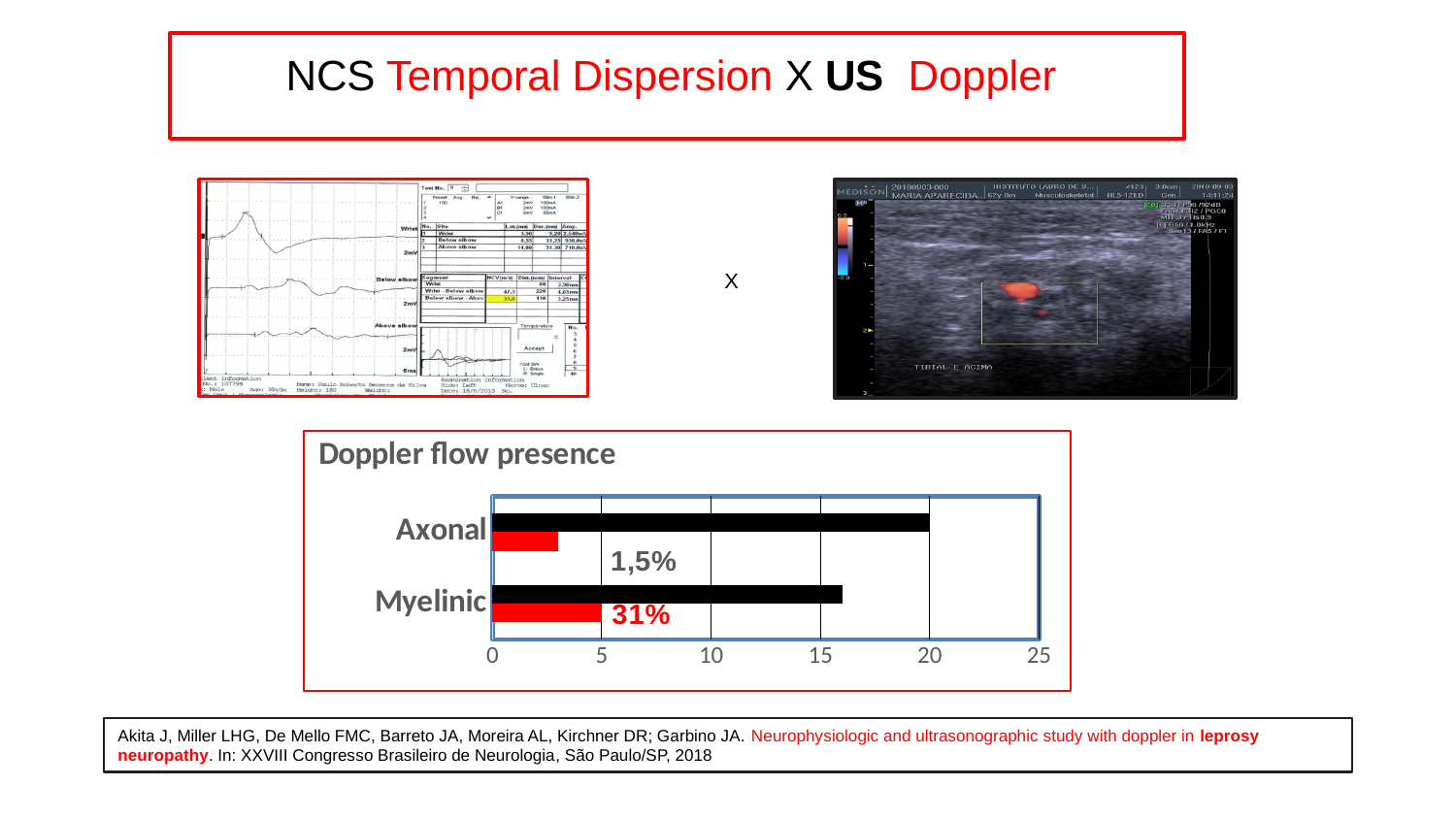
What percentage label is printed next to the Myelinic bars in the Doppler flow presence chart? 31% In the Doppler flow presence chart, which category has the longer red bar, Axonal or Myelinic? Myelinic In the Doppler flow presence chart, is the red bar for Axonal greater or less than 5? less What is the title of the chart on the slide? Doppler flow presence What percentage label is printed below the Axonal bars in the Doppler flow presence chart? 1,5% What is the maximum value shown on the horizontal axis of the Doppler flow presence chart? 25 How many categories are shown on the vertical axis of the Doppler flow presence chart? 2 What are the two categories listed on the Doppler flow presence chart? Axonal and Myelinic In the Doppler flow presence chart, is the black bar for Axonal greater or less than 15? greater In the Doppler flow presence chart, which category has the longer black bar, Axonal or Myelinic? Axonal What kind of chart is shown under the title "Doppler flow presence"? bar chart In the Doppler flow presence chart, is the black bar for Myelinic greater or less than 20? less